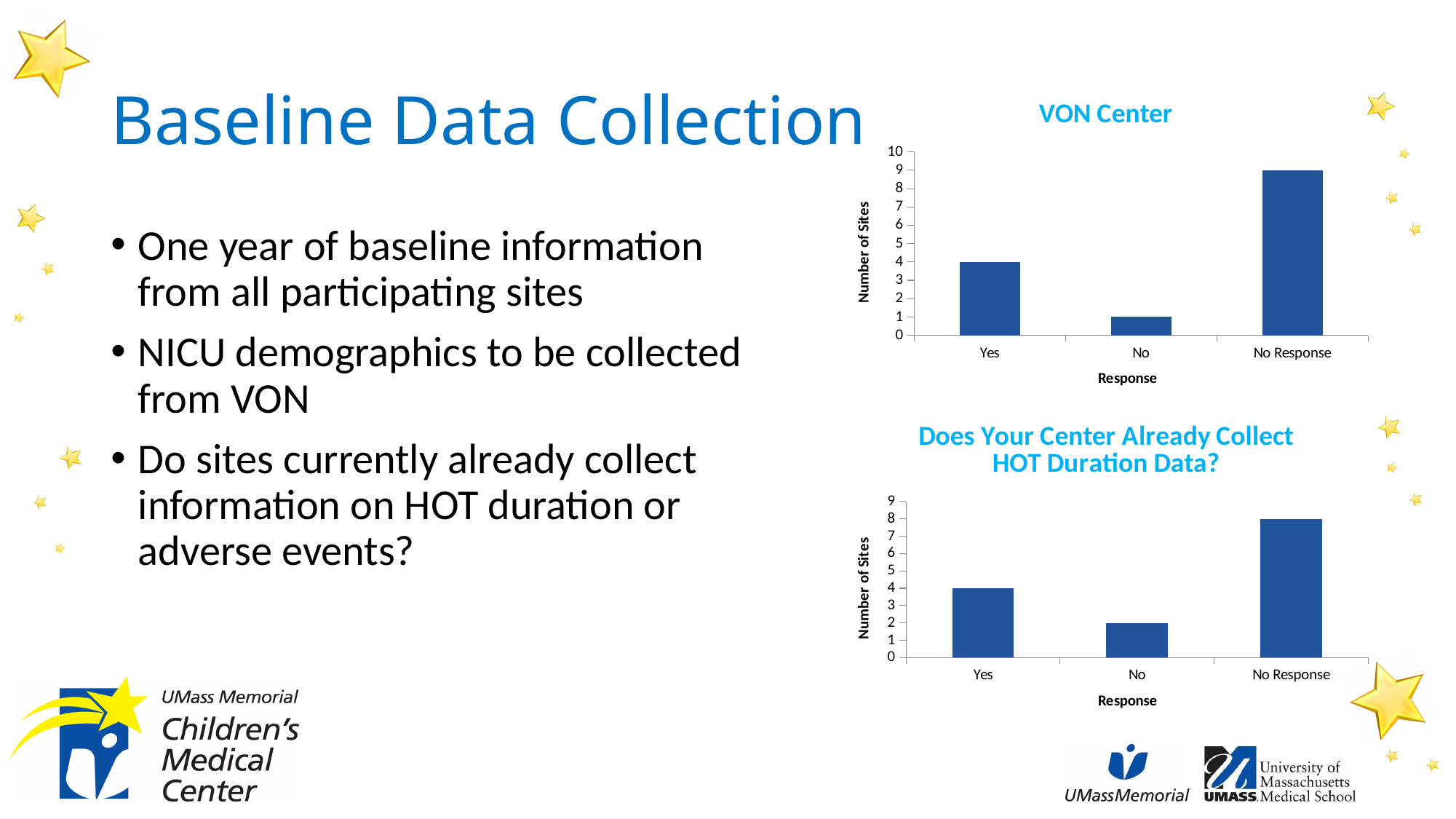
In the 'Does Your Center Already Collect HOT Duration Data?' chart, which response has the highest number of sites? No Response In the 'VON Center' chart, what is the difference in number of sites between 'No Response' and 'Yes'? 5 In the 'VON Center' chart, what is the number of sites for 'No Response'? 9 What kind of chart is the 'VON Center' chart? Bar chart In the 'Does Your Center Already Collect HOT Duration Data?' chart, what is the number of sites for 'No Response'? 8 In the 'VON Center' chart, what is the number of sites for 'Yes'? 4 In the 'VON Center' chart, which response has the lowest number of sites? No In the 'Does Your Center Already Collect HOT Duration Data?' chart, what is the number of sites for 'No'? 2 What is the y-axis label of the 'Does Your Center Already Collect HOT Duration Data?' chart? Number of Sites In the 'Does Your Center Already Collect HOT Duration Data?' chart, what is the difference in number of sites between 'Yes' and 'No'? 2 In the 'Does Your Center Already Collect HOT Duration Data?' chart, which is larger, the value for 'Yes' or the value for 'No'? Yes In the 'VON Center' chart, how many response categories are shown on the x axis? 3